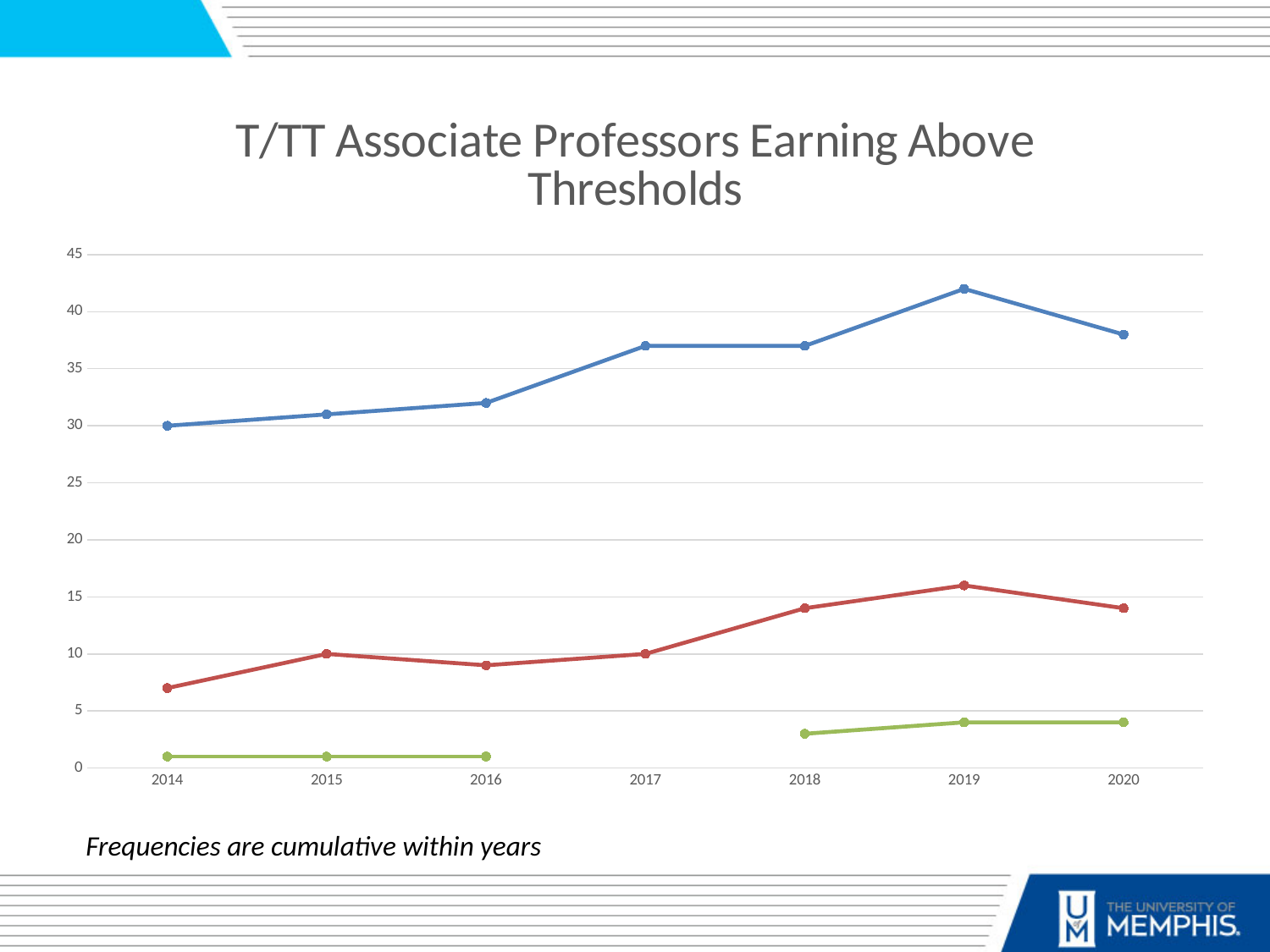
Is the value of the blue line in 2019 greater or less than 40? greater What is the value of the blue line in 2014? 30 What is the title of the chart? T/TT Associate Professors Earning Above Thresholds Is the value of the green line in 2019 greater or less than 5? less In which year is the blue line at its lowest value? 2014 In which year does the red line reach its highest value? 2019 Is the value of the red line in 2018 greater or less than 10? greater In which year does the blue line reach its highest value? 2019 What kind of chart is shown on the slide? line chart What is the value of the red line in 2015? 10 In 2020, which line has the larger value, the blue line or the red line? blue line How many years are shown on the x axis of the chart? 7